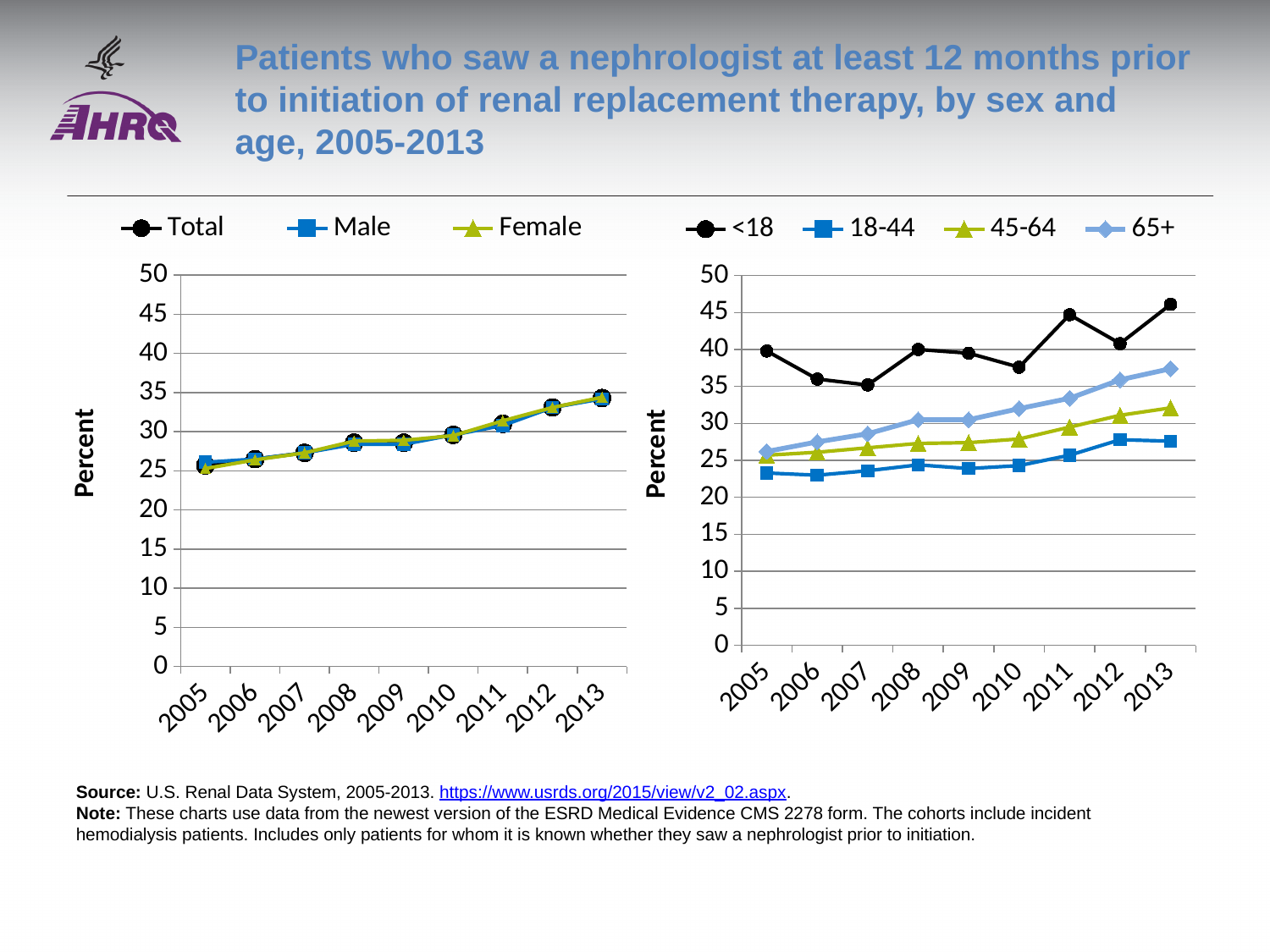
In the left chart (by sex), is the Total value for 2013 greater or less than 30? greater What is the y-axis label on the right chart (by age)? Percent How many series does the legend of the right chart (by age) list? 4 In the right chart (by age), which age group has the highest value in 2013? <18 In the left chart (by sex), does the Total series rise or fall from 2005 to 2013? Rise In the right chart (by age), is the value for 18-44 in 2005 greater or less than 25? less In the right chart (by age), which is larger in 2013: 65+ or 45-64? 65+ In the right chart (by age), which age group has the lowest value in 2005? 18-44 In the right chart (by age), is the value for <18 in 2013 greater or less than 40? greater How many years are shown on the x axis of the left chart (by sex)? 9 What kind of chart is the left chart (by sex)? Line chart